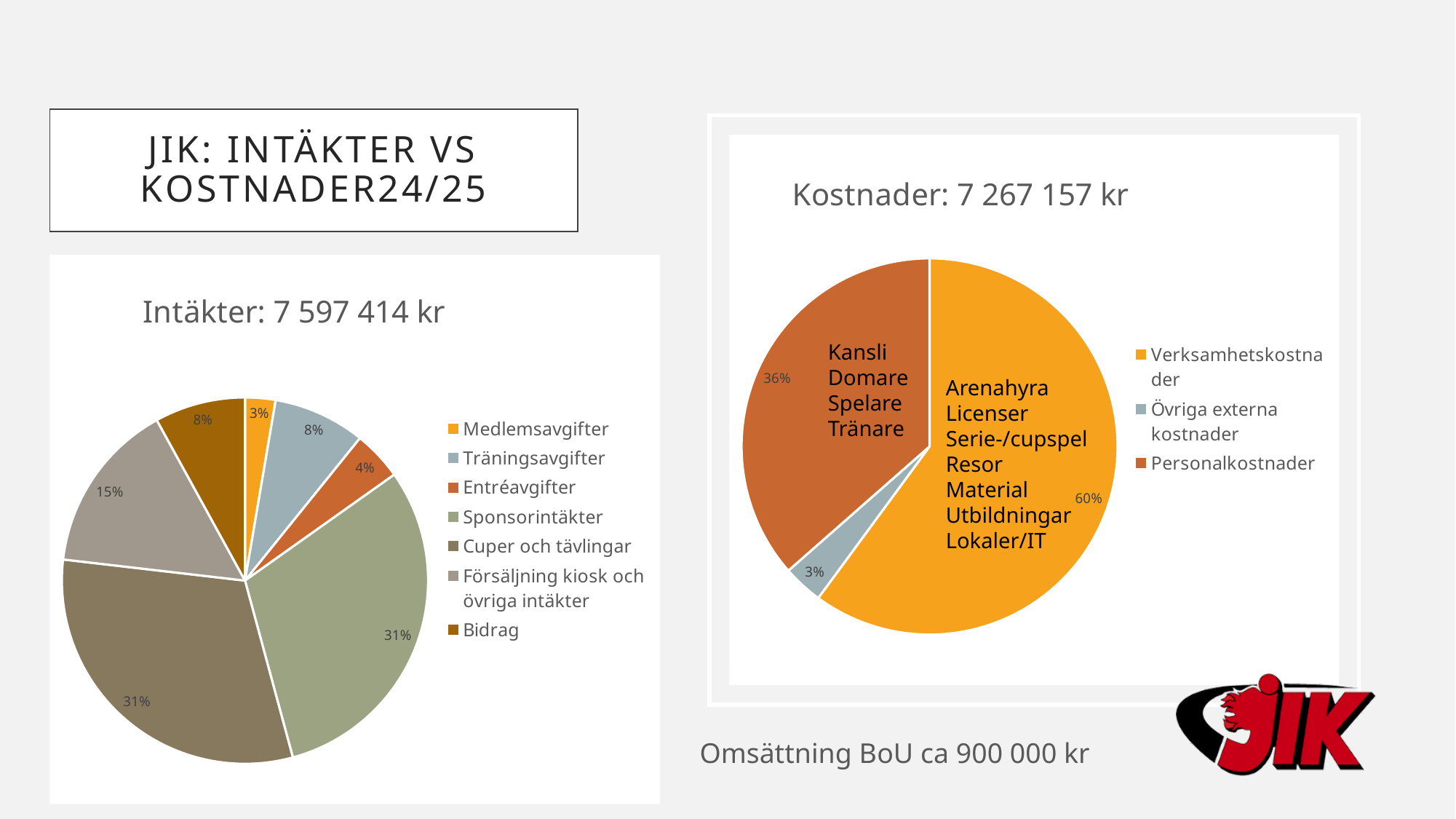
What type of chart is the Kostnader chart? Pie chart In the Intäkter pie chart, what share is Bidrag? 8% In the Intäkter pie chart, what share is Försäljning kiosk och övriga intäkter? 15% In the Intäkter pie chart, what is the difference in share between Försäljning kiosk och övriga intäkter and Bidrag? 7% In the Kostnader pie chart, what share is Personalkostnader? 36% In the Intäkter pie chart, how many categories does the legend list? 7 In the Kostnader pie chart, what is the difference in share between Verksamhetskostnader and Personalkostnader? 24% In the Intäkter pie chart, which category has the smallest share? Medlemsavgifter In the Intäkter pie chart, which is larger, Träningsavgifter or Entréavgifter? Träningsavgifter What total amount is shown in the title of the Kostnader chart? 7 267 157 kr In the Kostnader pie chart, which category has the largest share? Verksamhetskostnader